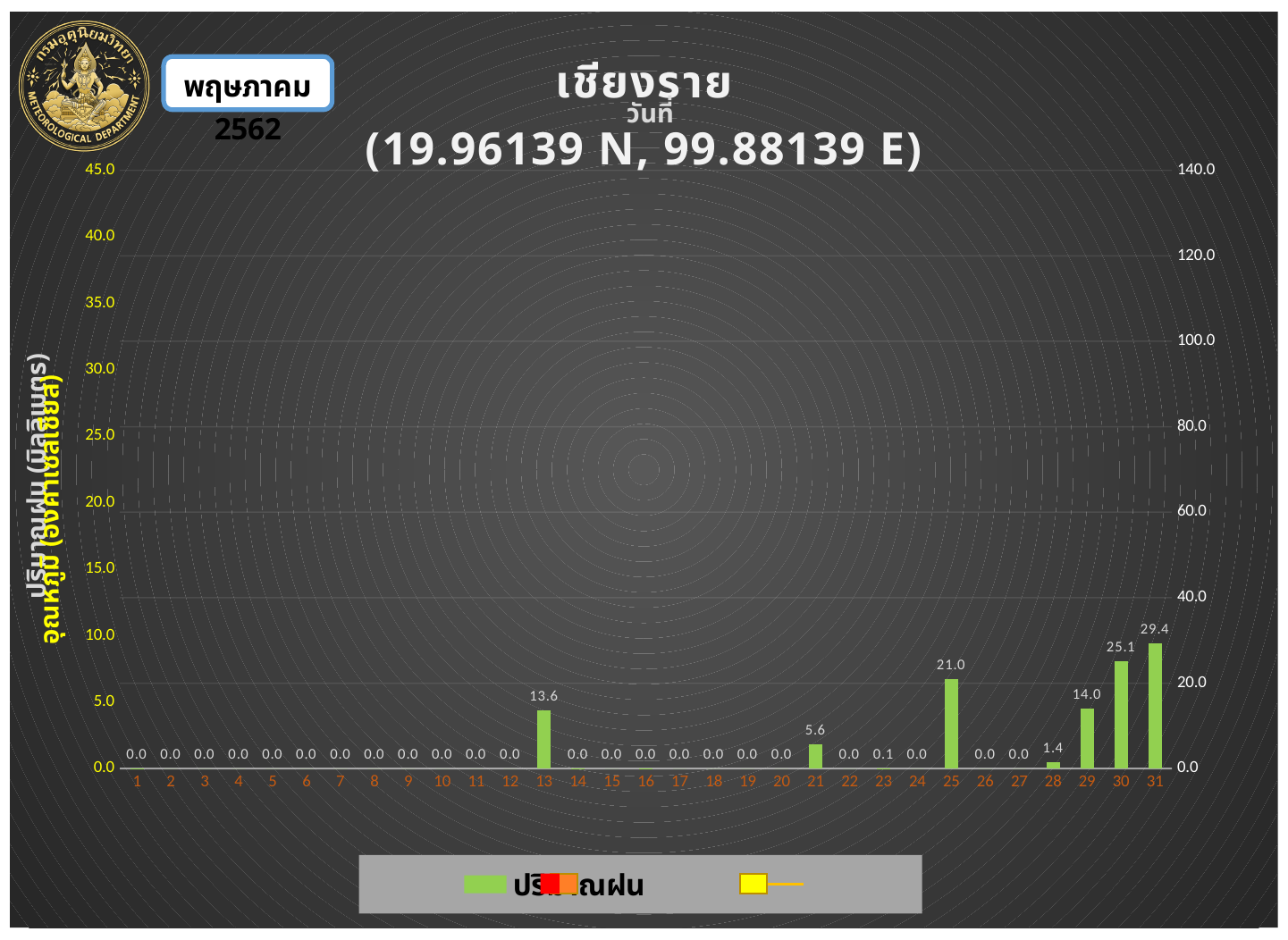
What is the rainfall value shown for day 31? 29.4 What is the difference between the rainfall values for day 31 and day 30? 4.3 Which day has the highest rainfall value? 31 What is the rainfall value shown for day 25? 21.0 Which has a larger rainfall value, day 25 or day 29? Day 25 What is the rainfall value shown for day 23? 0.1 How many days are shown on the x axis? 31 Is the bar for day 31 greater or less than 20.0 on the right-hand axis? greater What is the rainfall value shown for day 13? 13.6 What is the rainfall value shown for day 28? 1.4 What kind of chart is shown on the slide? Bar chart What is the difference between the rainfall values for day 25 and day 21? 15.4